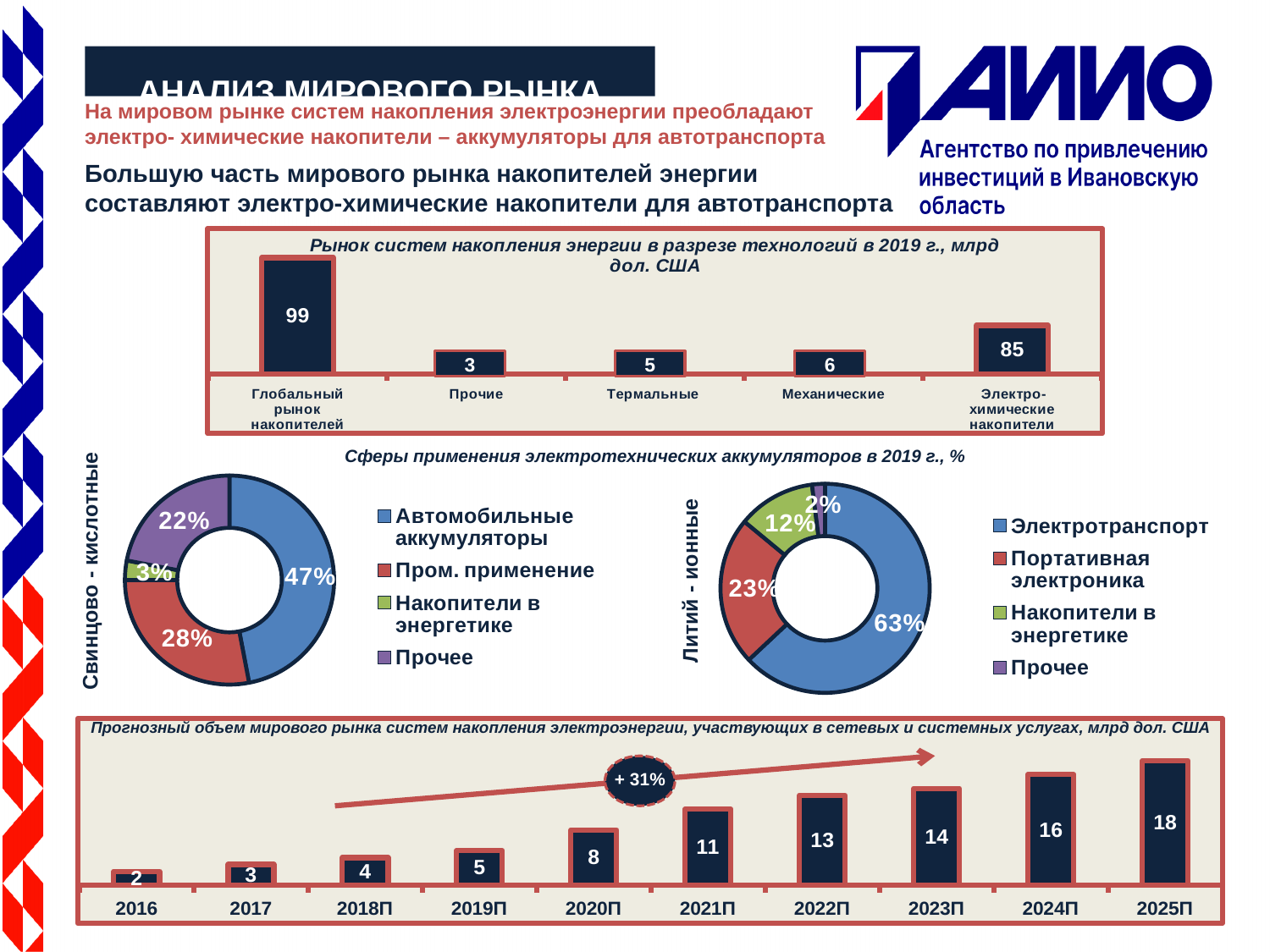
In the right donut chart (Литий-ионные), how many entries does the legend list? 4 In the top bar chart (Рынок систем накопления энергии в разрезе технологий в 2019 г.), what is the value for Электро-химические накопители? 85 In the right donut chart (Литий-ионные), which category has the smallest share? Прочее In the left donut chart (Свинцово-кислотные), which category has the largest share? Автомобильные аккумуляторы In the left donut chart (Свинцово-кислотные), what share is Пром. применение? 28% In the bottom bar chart (Прогнозный объем мирового рынка систем накопления электроэнергии), what is the difference between 2025П and 2016? 16 In the bottom bar chart (Прогнозный объем мирового рынка систем накопления электроэнергии), what is the value for 2022П? 13 In the top bar chart (Рынок систем накопления энергии в разрезе технологий в 2019 г.), what is the difference between Глобальный рынок накопителей and Электро-химические накопители? 14 In the bottom bar chart (Прогнозный объем мирового рынка систем накопления электроэнергии), do the values rise or fall from 2016 to 2025П? rise In the top bar chart (Рынок систем накопления энергии в разрезе технологий в 2019 г.), which category has the lowest value? Прочие In the top bar chart (Рынок систем накопления энергии в разрезе технологий в 2019 г.), how many categories are shown? 5 In the right donut chart (Литий-ионные), what share is Портативная электроника? 23%